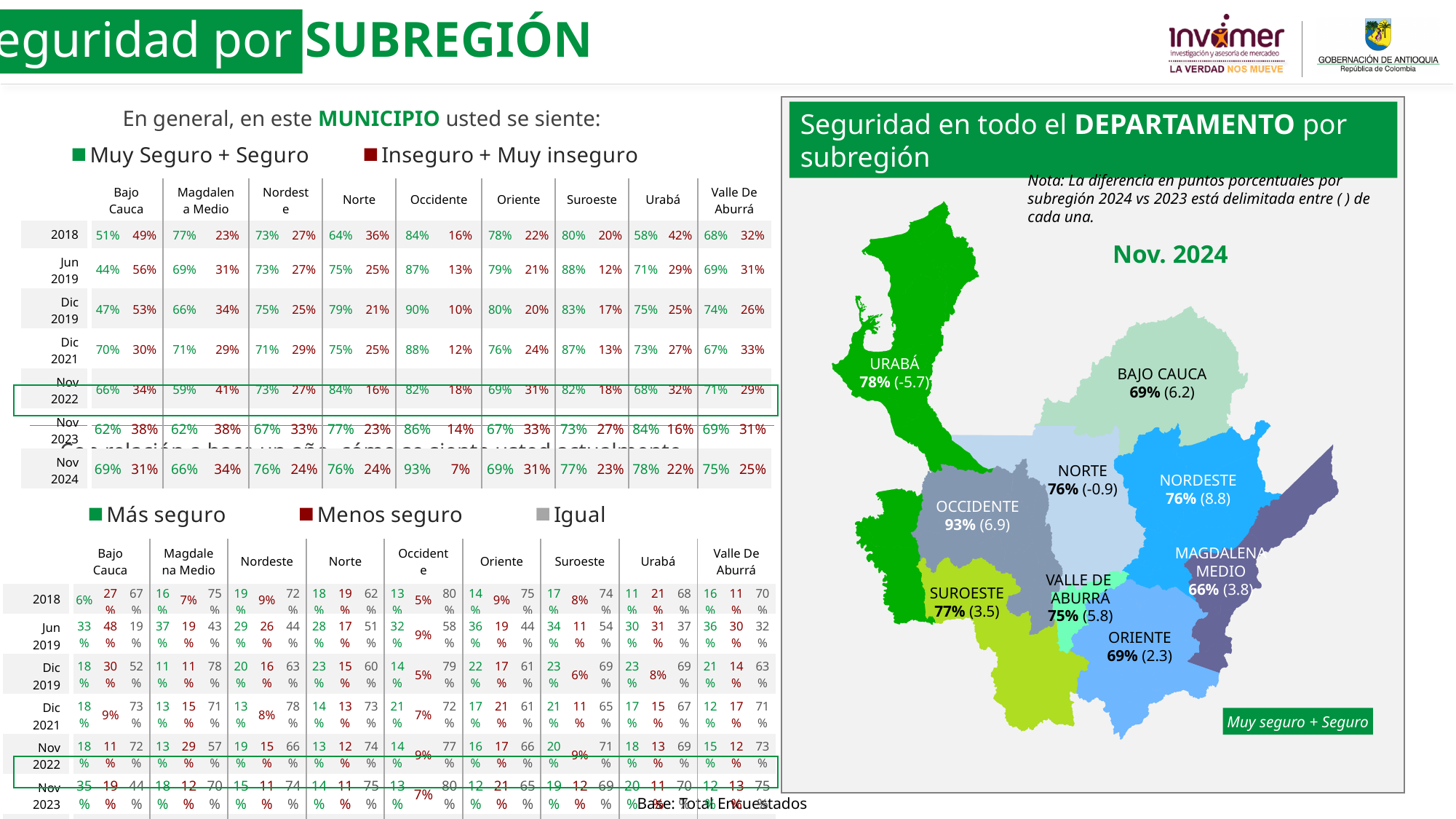
On the map 'Seguridad en todo el DEPARTAMENTO por subregión', what is the difference in percentage points between Occidente and Bajo Cauca? 24 On the map 'Seguridad en todo el DEPARTAMENTO por subregión', what is the change in percentage points shown in parentheses for Urabá? -5.7 In the top table 'En general, en este MUNICIPIO usted se siente', what is the Inseguro + Muy inseguro value for Bajo Cauca in Jun 2019? 56% On the map 'Seguridad en todo el DEPARTAMENTO por subregión', which subregion has the highest Muy seguro + Seguro percentage? Occidente On the map 'Seguridad en todo el DEPARTAMENTO por subregión', which has a higher Muy seguro + Seguro value, Urabá or Suroeste? Urabá How many series does the legend of the top table 'En general, en este MUNICIPIO usted se siente' list? 2 Which period does the map 'Seguridad en todo el DEPARTAMENTO por subregión' show data for? Nov. 2024 On the map 'Seguridad en todo el DEPARTAMENTO por subregión', what is the Muy seguro + Seguro value for Occidente in Nov. 2024? 93% How many subregions are labelled with values on the map 'Seguridad en todo el DEPARTAMENTO por subregión'? 9 On the map 'Seguridad en todo el DEPARTAMENTO por subregión', which subregion shows the largest increase in parentheses versus 2023? Nordeste On the map 'Seguridad en todo el DEPARTAMENTO por subregión', which subregion has the lowest Muy seguro + Seguro percentage? Magdalena Medio In the top table 'En general, en este MUNICIPIO usted se siente', what is the Muy Seguro + Seguro value for Occidente in 2018? 84%